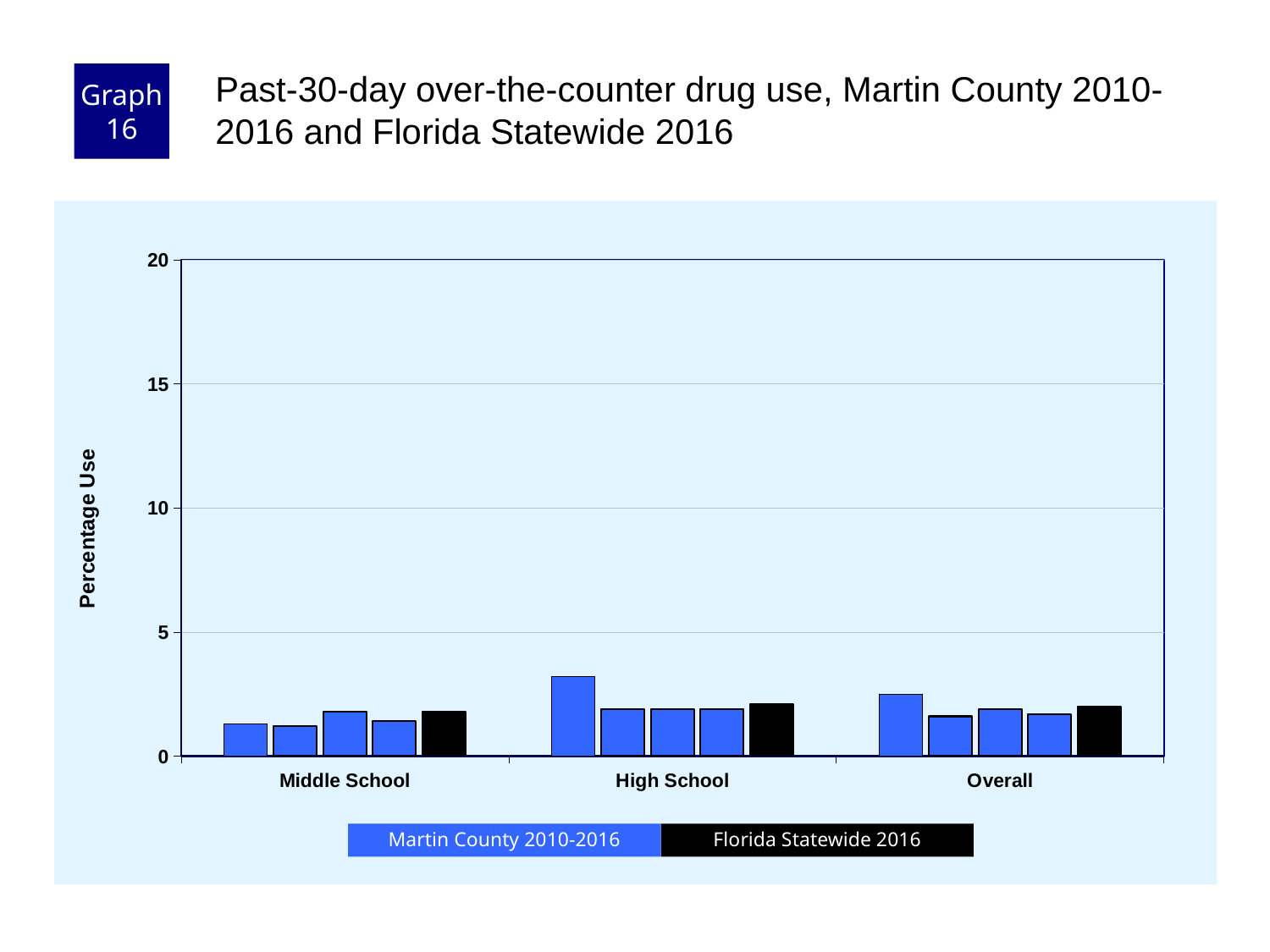
Is the Florida Statewide 2016 value for High School greater or less than 5? less How many series does the legend list? 2 Which series is shown in black in the legend? Florida Statewide 2016 Which is larger: the tallest Martin County bar for High School or the tallest Martin County bar for Middle School? High School What kind of chart is shown on the slide? bar chart How many categories are shown on the x axis? 3 What is the label on the y axis? Percentage Use Is the Florida Statewide 2016 value for Overall greater or less than 10? less Which category contains the tallest bar in the chart? High School Are any of the bars for Middle School greater than 5? No